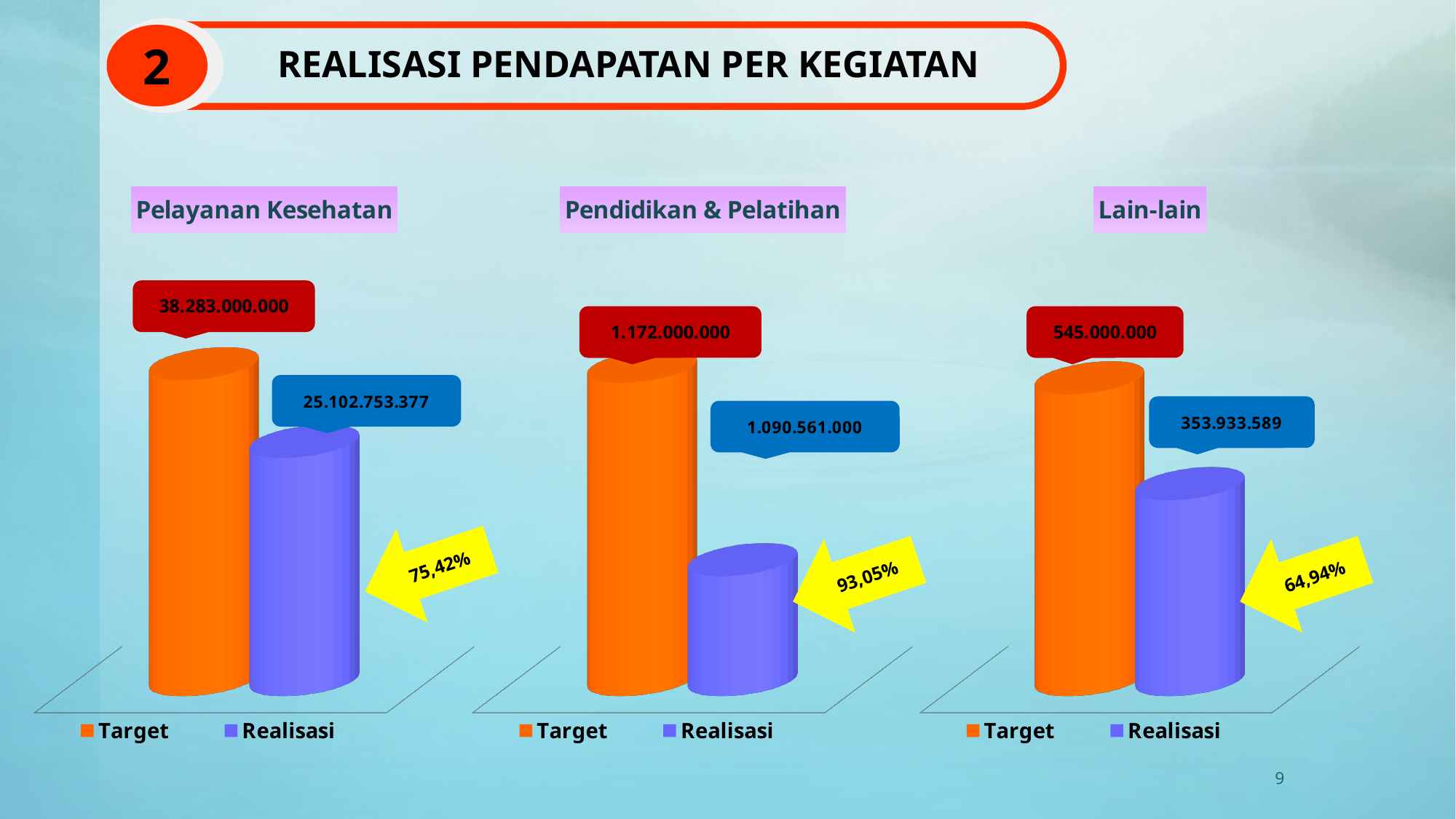
In the Pendidikan & Pelatihan chart, what is the difference between Target and Realisasi? 81.439.000 In the Pendidikan & Pelatihan chart, what is the value of Realisasi? 1.090.561.000 In the Pendidikan & Pelatihan chart, what is the value of Target? 1.172.000.000 In the Pendidikan & Pelatihan chart, what percentage is shown in the yellow arrow? 93,05% In the Pelayanan Kesehatan chart, what is the value of Target? 38.283.000.000 In the Pelayanan Kesehatan chart, what is the value of Realisasi? 25.102.753.377 In the Lain-lain chart, what is the value of Realisasi? 353.933.589 In the Lain-lain chart, which bar is the lowest? Realisasi In the Lain-lain chart, what is the difference between Target and Realisasi? 191.066.411 How many series does the legend of the Pendidikan & Pelatihan chart list? 2 In the Pelayanan Kesehatan chart, which is larger, Target or Realisasi? Target What kind of chart is the Lain-lain chart? Bar chart